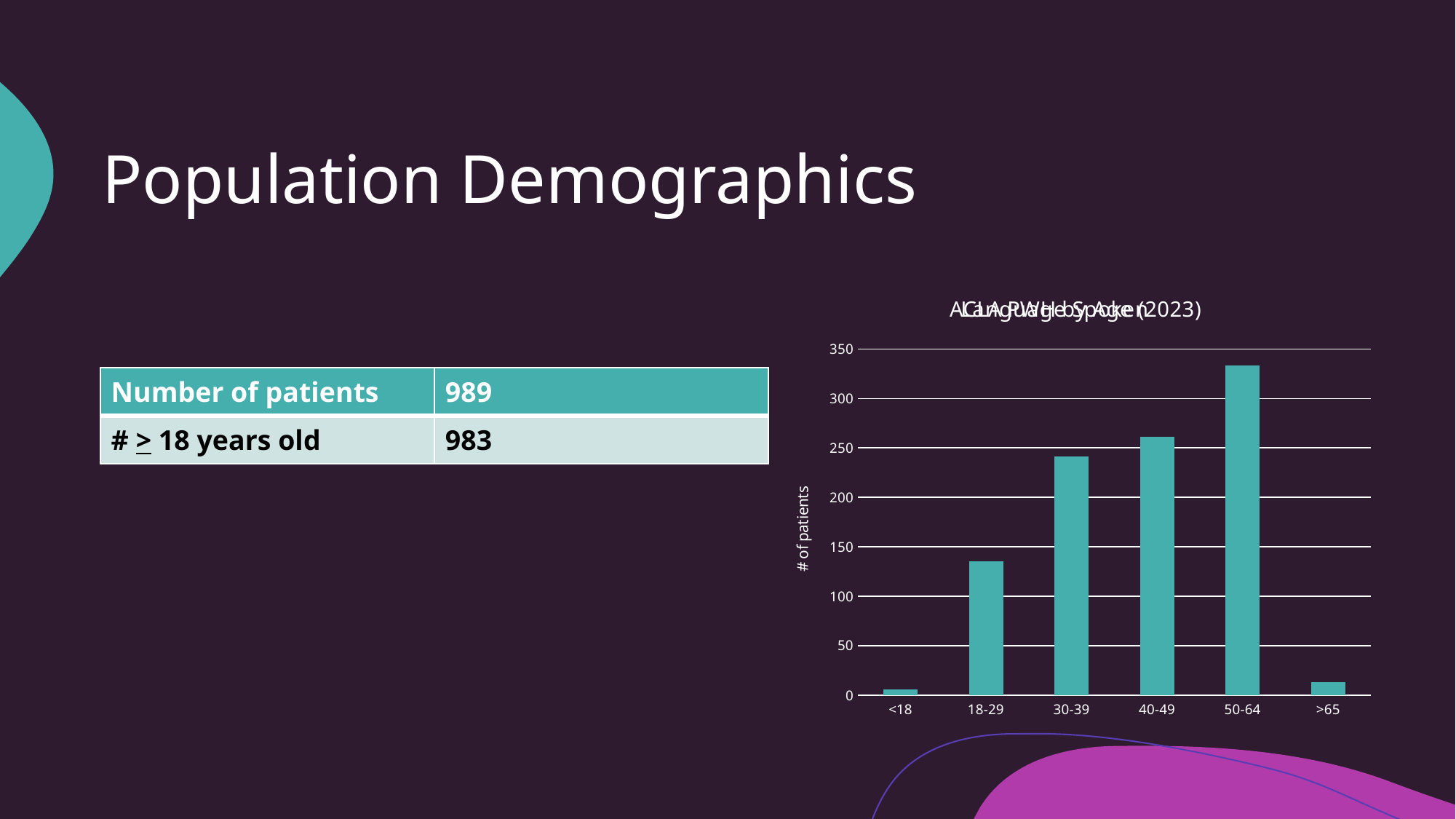
Is the value for 50-64 greater or less than 300? greater Is the value for 18-29 greater or less than 150? less Is the value for 18-29 greater or less than 100? greater Which has more patients in the chart, 50-64 or 40-49? 50-64 What is the label on the vertical axis of the chart? # of patients What kind of chart is shown on the slide? bar chart Which has more patients in the chart, 18-29 or 30-39? 30-39 Which age category has the highest number of patients in the chart? 50-64 Which age category has the lowest number of patients in the chart? <18 How many age categories are shown on the x axis of the chart? 6